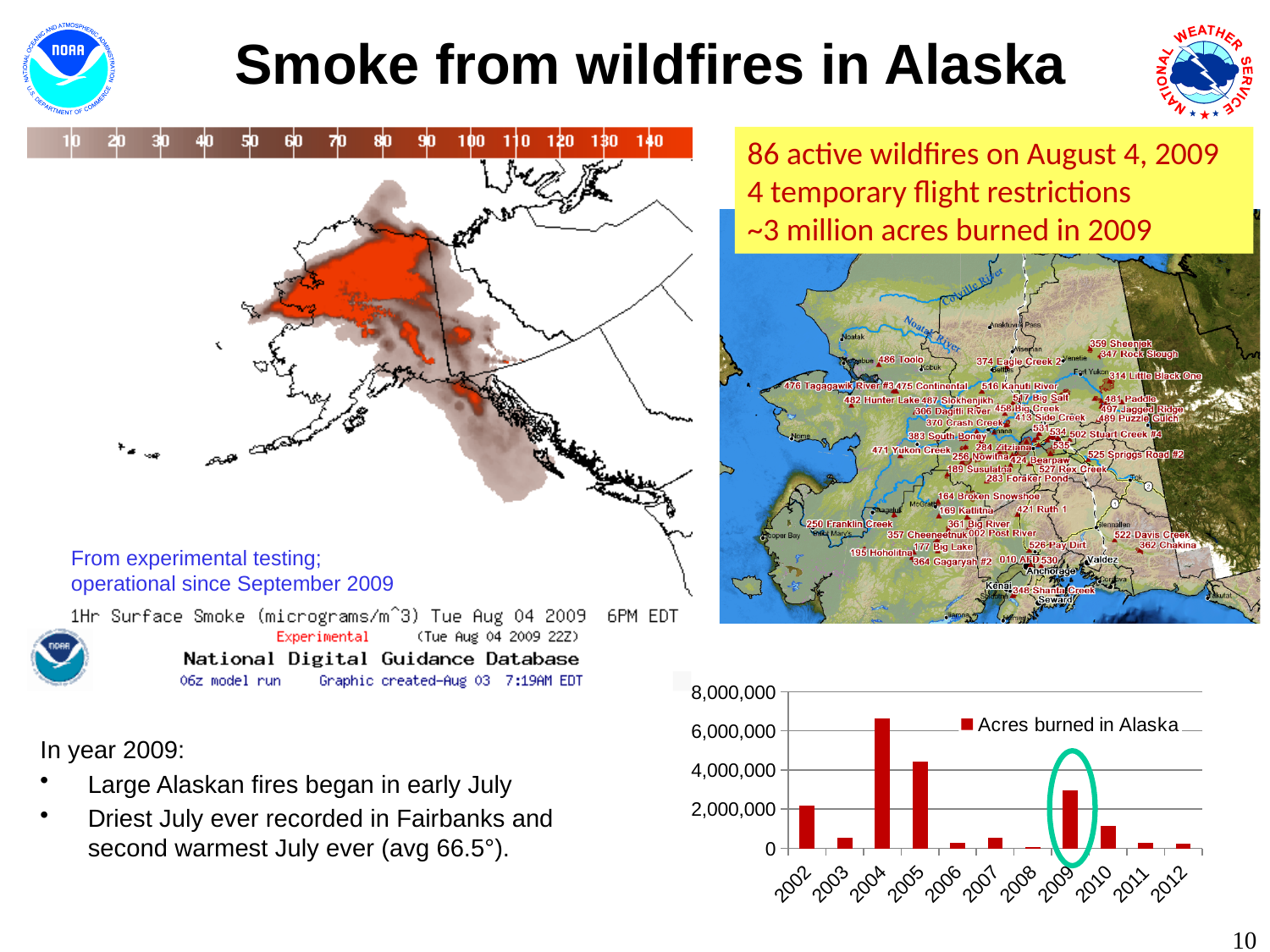
What kind of chart is shown at the bottom right of the slide? bar chart How many series does the legend of the bar chart list? 1 In the bar chart, which year has more acres burned, 2004 or 2005? 2004 What is the series name shown in the legend of the bar chart? Acres burned in Alaska In the bar chart, which year has more acres burned, 2009 or 2010? 2009 In the bar chart, is the value for 2005 greater or less than 4,000,000? greater In the bar chart, is the value for 2009 greater or less than 2,000,000? greater How many years are shown on the x axis of the bar chart? 11 Which year has the lowest value for acres burned in Alaska in the bar chart? 2008 In the bar chart, is the value for 2004 greater or less than 6,000,000? greater Which year has the highest value for acres burned in Alaska in the bar chart? 2004